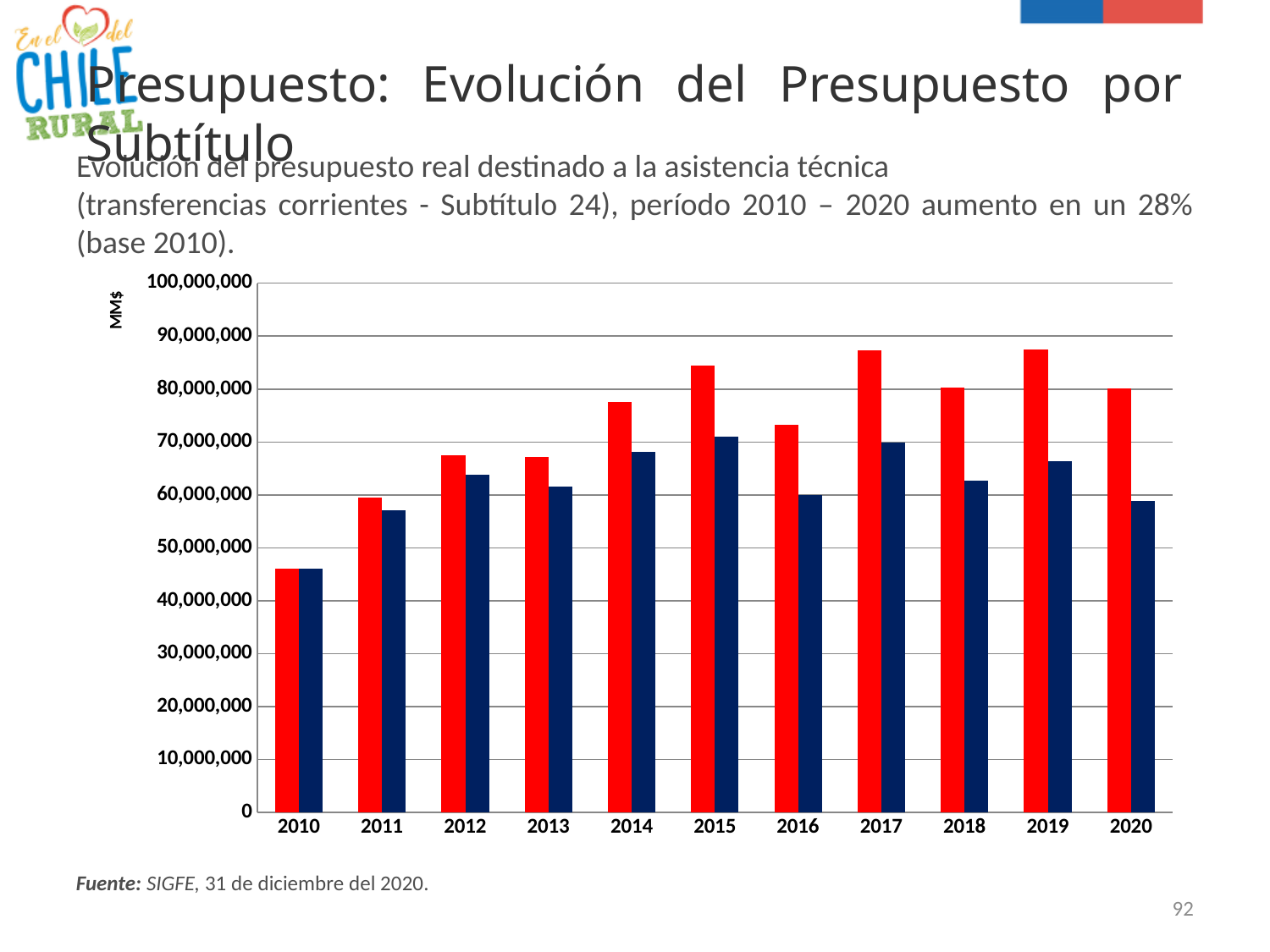
How many years are shown on the x axis of the chart? 11 Is the value of the red bar for 2015 greater or less than 80,000,000? greater How many bars are plotted for each year in the chart? 2 What kind of chart is shown on the slide? Bar chart Is the value of the dark blue bar for 2014 greater or less than 60,000,000? greater Which year has the lowest dark blue bar in the chart? 2010 What unit label is shown on the y axis of the chart? MM$ Is the value of the dark blue bar for 2020 greater or less than 60,000,000? less Which is larger, the red bar for 2017 or the red bar for 2016? 2017 Which year has the lowest red bar in the chart? 2010 Which is larger for 2020, the red bar or the dark blue bar? The red bar